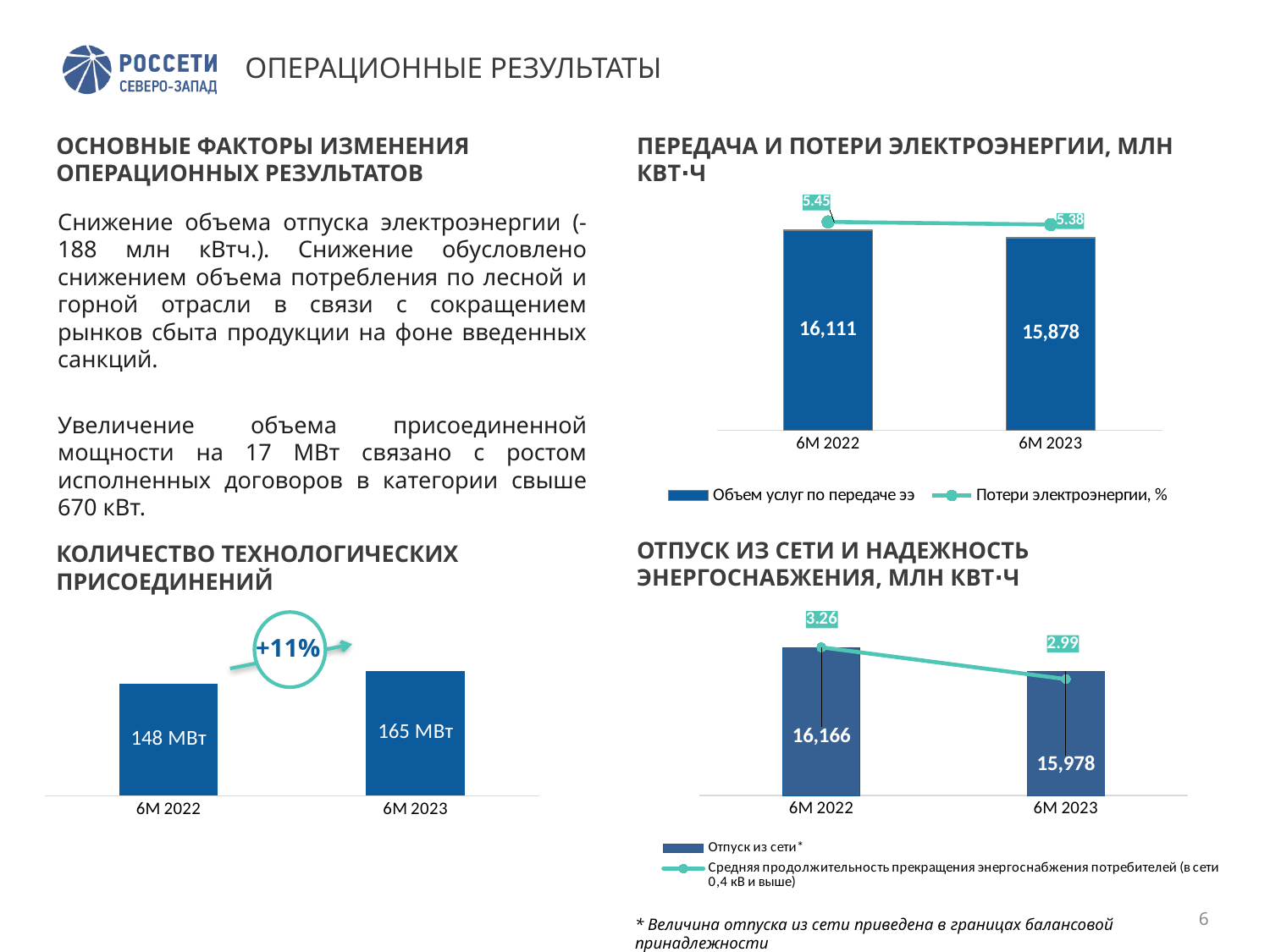
What type of chart is 'ОТПУСК ИЗ СЕТИ И НАДЕЖНОСТЬ ЭНЕРГОСНАБЖЕНИЯ, МЛН КВТ·Ч'? Combined bar and line chart In the chart 'ОТПУСК ИЗ СЕТИ И НАДЕЖНОСТЬ ЭНЕРГОСНАБЖЕНИЯ, МЛН КВТ·Ч', what is the value of 'Отпуск из сети' for 6M 2023? 15,978 In the chart 'ПЕРЕДАЧА И ПОТЕРИ ЭЛЕКТРОЭНЕРГИИ, МЛН КВТ·Ч', does 'Потери электроэнергии, %' rise or fall from 6M 2022 to 6M 2023? fall In the chart 'ПЕРЕДАЧА И ПОТЕРИ ЭЛЕКТРОЭНЕРГИИ, МЛН КВТ·Ч', what is the value of 'Потери электроэнергии, %' for 6M 2023? 5.38 In the chart 'ПЕРЕДАЧА И ПОТЕРИ ЭЛЕКТРОЭНЕРГИИ, МЛН КВТ·Ч', how many series does the legend list? 2 In the chart 'ПЕРЕДАЧА И ПОТЕРИ ЭЛЕКТРОЭНЕРГИИ, МЛН КВТ·Ч', what is the value of 'Объем услуг по передаче ээ' for 6M 2022? 16,111 In the chart 'КОЛИЧЕСТВО ТЕХНОЛОГИЧЕСКИХ ПРИСОЕДИНЕНИЙ', which period has the higher value? 6M 2023 In the chart 'КОЛИЧЕСТВО ТЕХНОЛОГИЧЕСКИХ ПРИСОЕДИНЕНИЙ', what percentage change is shown between 6M 2022 and 6M 2023? +11% In the chart 'ОТПУСК ИЗ СЕТИ И НАДЕЖНОСТЬ ЭНЕРГОСНАБЖЕНИЯ, МЛН КВТ·Ч', what is the value of the line series for 6M 2022? 3.26 In the chart 'КОЛИЧЕСТВО ТЕХНОЛОГИЧЕСКИХ ПРИСОЕДИНЕНИЙ', what is the value for 6M 2023? 165 МВт In the chart 'ОТПУСК ИЗ СЕТИ И НАДЕЖНОСТЬ ЭНЕРГОСНАБЖЕНИЯ, МЛН КВТ·Ч', what is the difference in 'Отпуск из сети' between 6M 2022 and 6M 2023? 188 In the chart 'ПЕРЕДАЧА И ПОТЕРИ ЭЛЕКТРОЭНЕРГИИ, МЛН КВТ·Ч', by how much did 'Объем услуг по передаче ээ' change from 6M 2022 to 6M 2023? 233